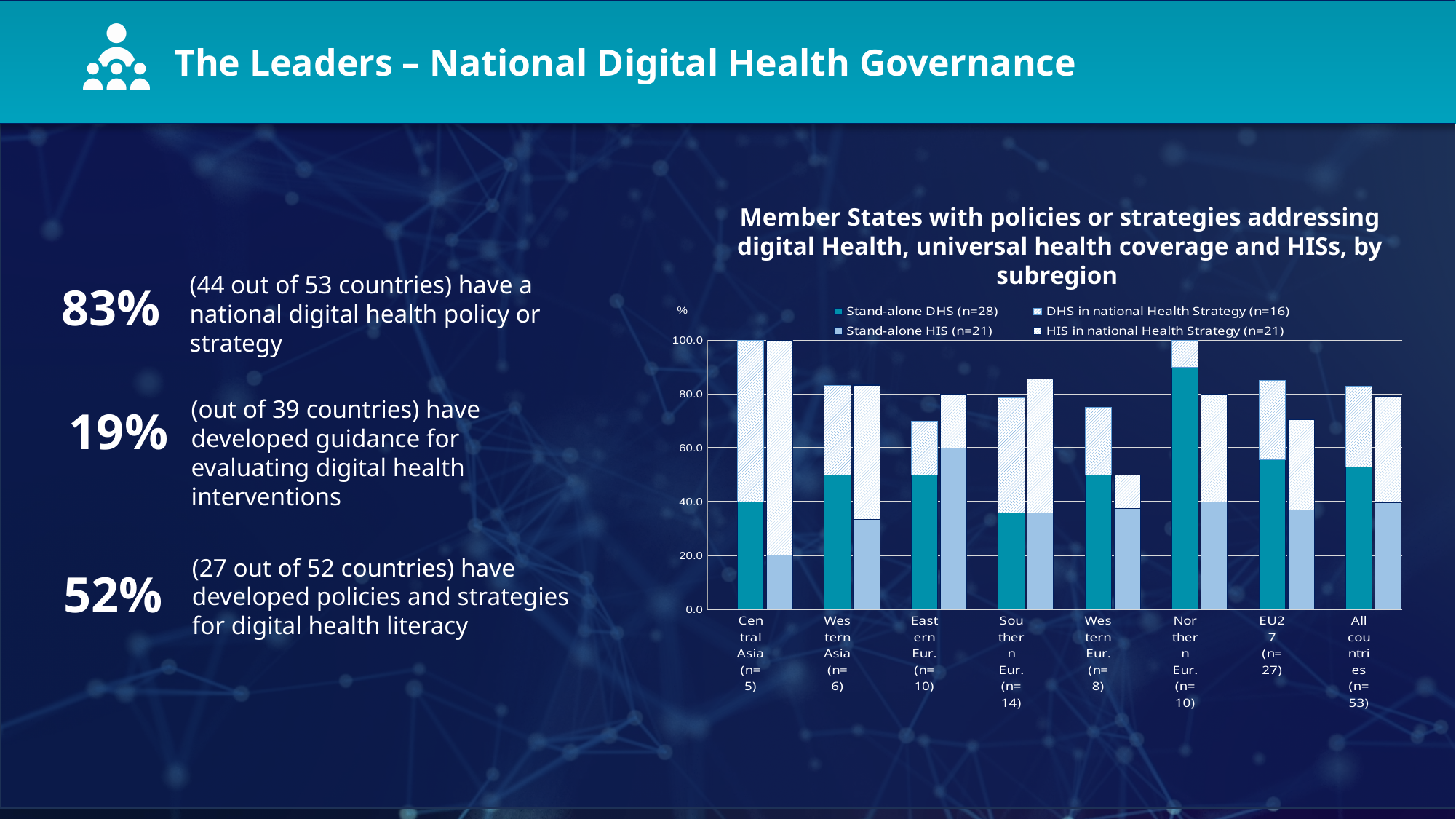
Which subregion has the highest Stand-alone DHS value? Northern Eur. (n=10) Which legend entry is shown with the solid teal colour? Stand-alone DHS (n=28) What is the title of the chart? Member States with policies or strategies addressing digital Health, universal health coverage and HISs, by subregion What is the value of the Stand-alone DHS segment for Central Asia (n=5)? 40.0 What kind of chart is shown on the slide? Stacked bar chart How many series does the chart legend list? 4 What is the total height of the DHS bar (Stand-alone DHS plus DHS in national Health Strategy) for Central Asia (n=5)? 100.0 Is the Stand-alone DHS value for Southern Eur. (n=14) greater or less than 40? less Is the Stand-alone DHS value for Northern Eur. (n=10) greater or less than 80? greater What is the value of the Stand-alone HIS segment for Eastern Eur. (n=10)? 60.0 How many subregion categories are shown on the x axis of the chart? 8 Which is larger: the Stand-alone DHS value for Western Asia (n=6) or the Stand-alone DHS value for Southern Eur. (n=14)? Western Asia (n=6)